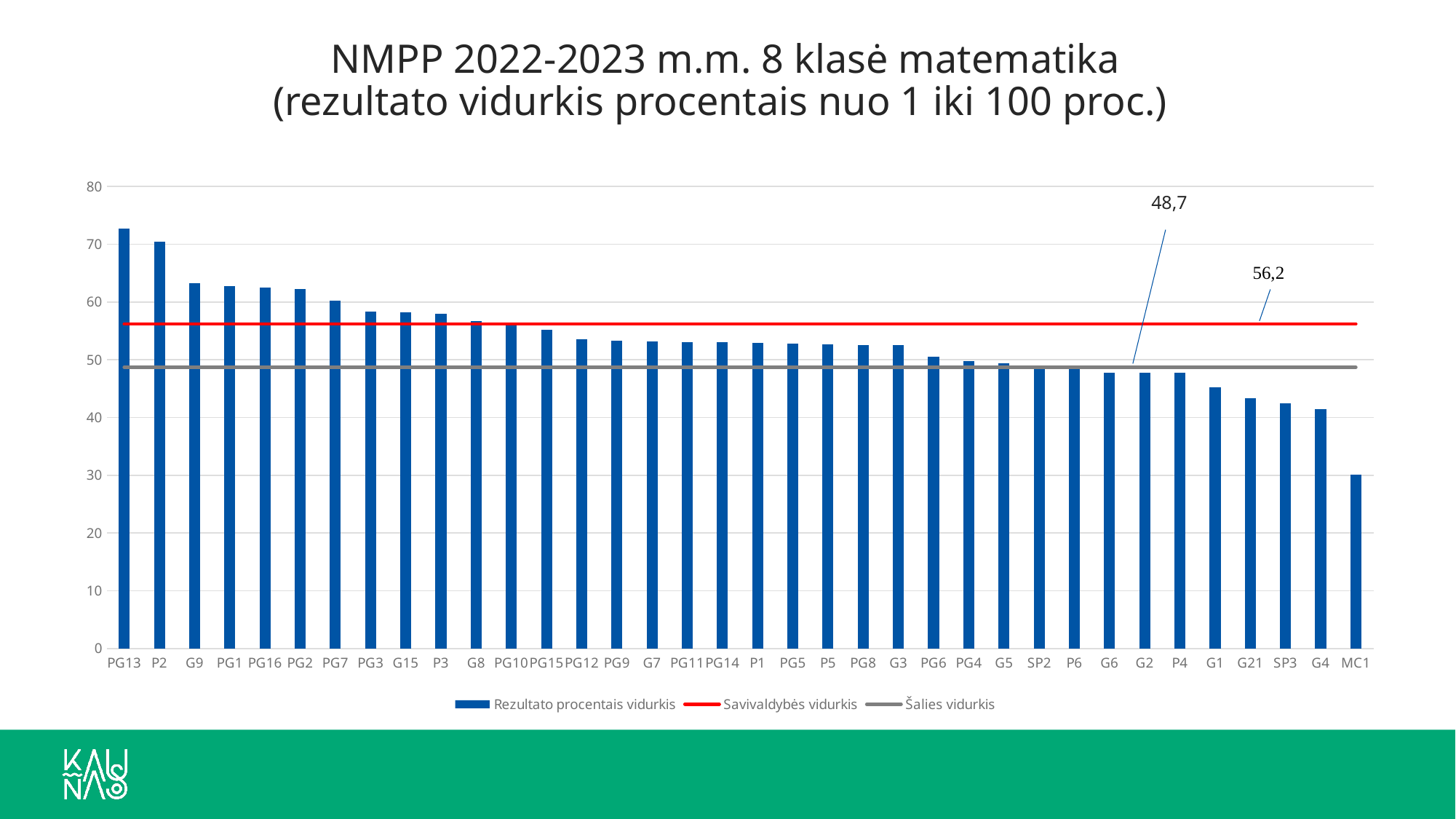
What is the difference between the Savivaldybės vidurkis and the Šalies vidurkis? 7,5 Is the value for PG13 greater or less than 70? greater Do the bar values rise or fall from left to right along the x axis? fall Which category has the highest value? PG13 Which category has the lowest value? MC1 Which is larger, the value for G9 or the value for G4? G9 Is the value for MC1 greater or less than 40? less What type of chart is shown on the slide? bar chart How many categories (bars) are shown on the x axis? 36 What is the value of the Savivaldybės vidurkis line? 56,2 How many series does the legend list? 3 What is the value of the Šalies vidurkis line? 48,7